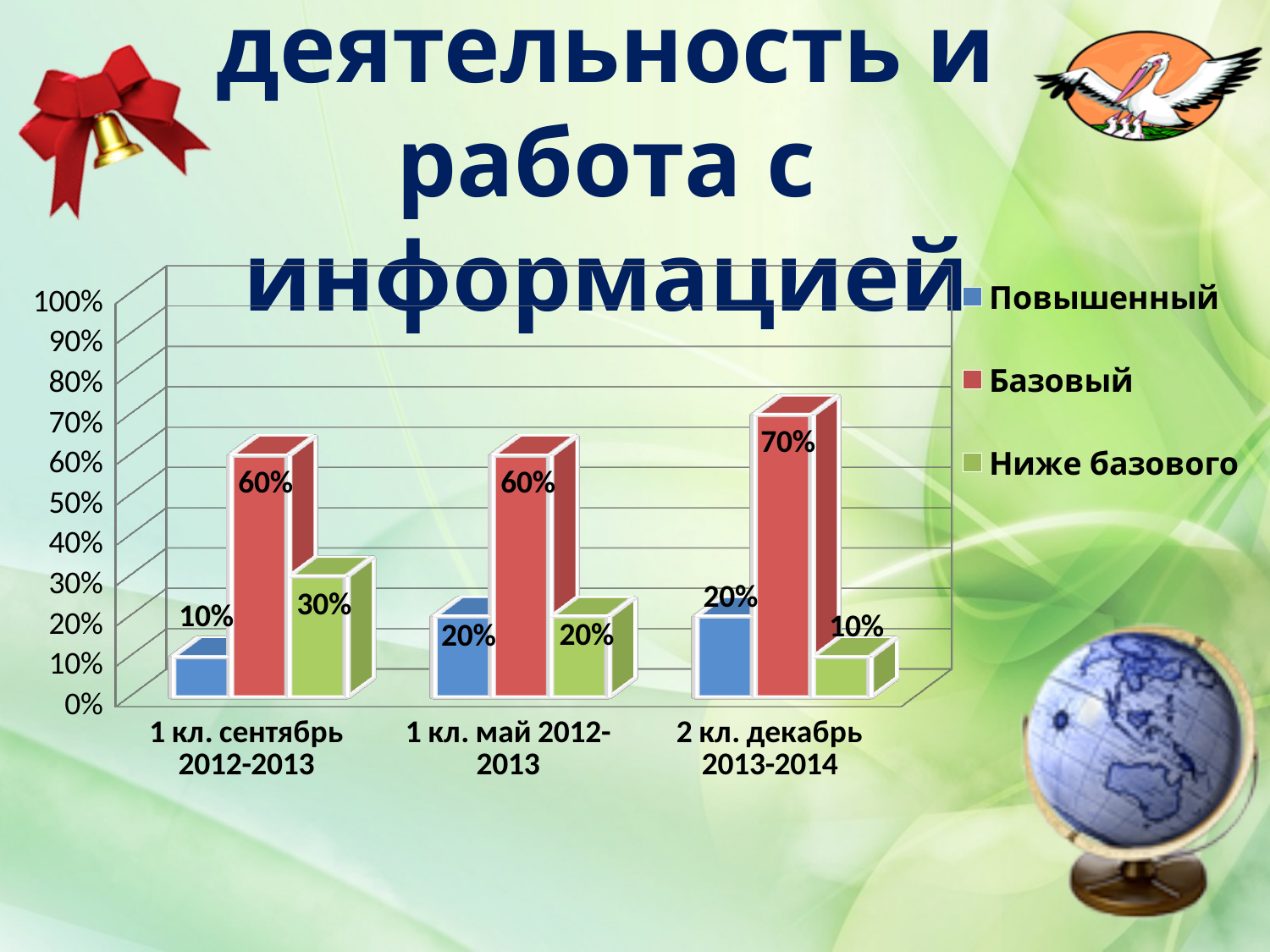
What is the value of Базовый for 2 кл. декабрь 2013-2014? 70% Which is larger for 2 кл. декабрь 2013-2014: Повышенный or Ниже базового? Повышенный What kind of chart is shown on the slide? Bar chart What is the value of Базовый for 1 кл. сентябрь 2012-2013? 60% In which category is the Базовый value highest? 2 кл. декабрь 2013-2014 How many series does the legend list? 3 What is the value of Ниже базового for 1 кл. май 2012-2013? 20% What is the value of Повышенный for 1 кл. сентябрь 2012-2013? 10% In which category is the Ниже базового value lowest? 2 кл. декабрь 2013-2014 What is the difference between the Базовый and Ниже базового values for 1 кл. сентябрь 2012-2013? 30% How many categories are shown on the x axis? 3 What is the value of Ниже базового for 2 кл. декабрь 2013-2014? 10%